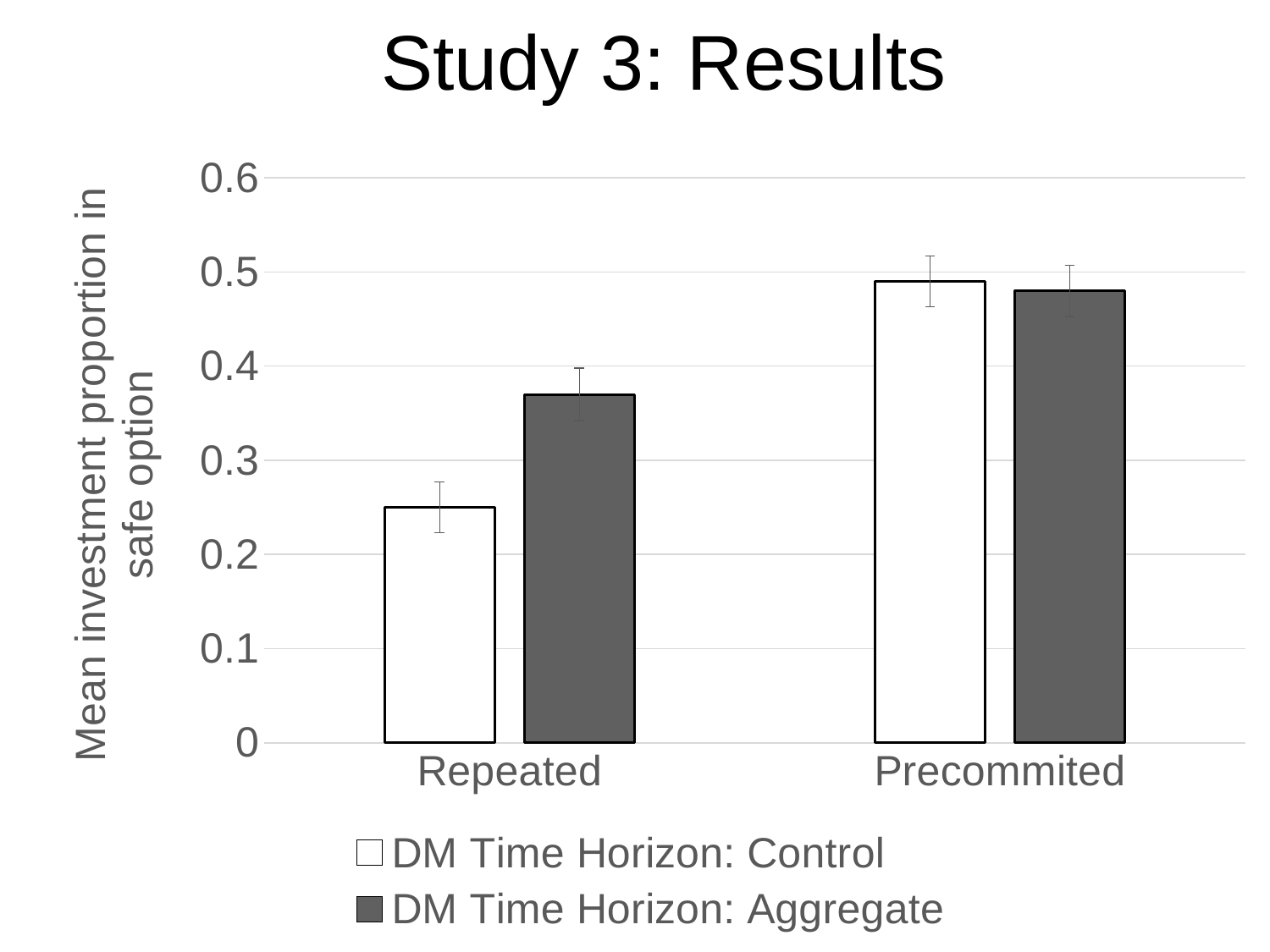
Is the value for DM Time Horizon: Control in the Repeated condition greater or less than 0.3? less Is the value for DM Time Horizon: Aggregate in the Repeated condition greater or less than 0.3? greater How many series does the legend list? 2 How many categories are shown on the x axis? 2 Is the value for DM Time Horizon: Aggregate in the Precommited condition greater or less than 0.4? greater What kind of chart is shown on the slide? bar chart What is the label on the vertical axis? Mean investment proportion in safe option In the Repeated condition, which series has the larger value, DM Time Horizon: Control or DM Time Horizon: Aggregate? DM Time Horizon: Aggregate What is the title of the chart? Study 3: Results Which bar has the lowest value in the chart? DM Time Horizon: Control, Repeated For the DM Time Horizon: Control series, which condition has the higher value, Repeated or Precommited? Precommited